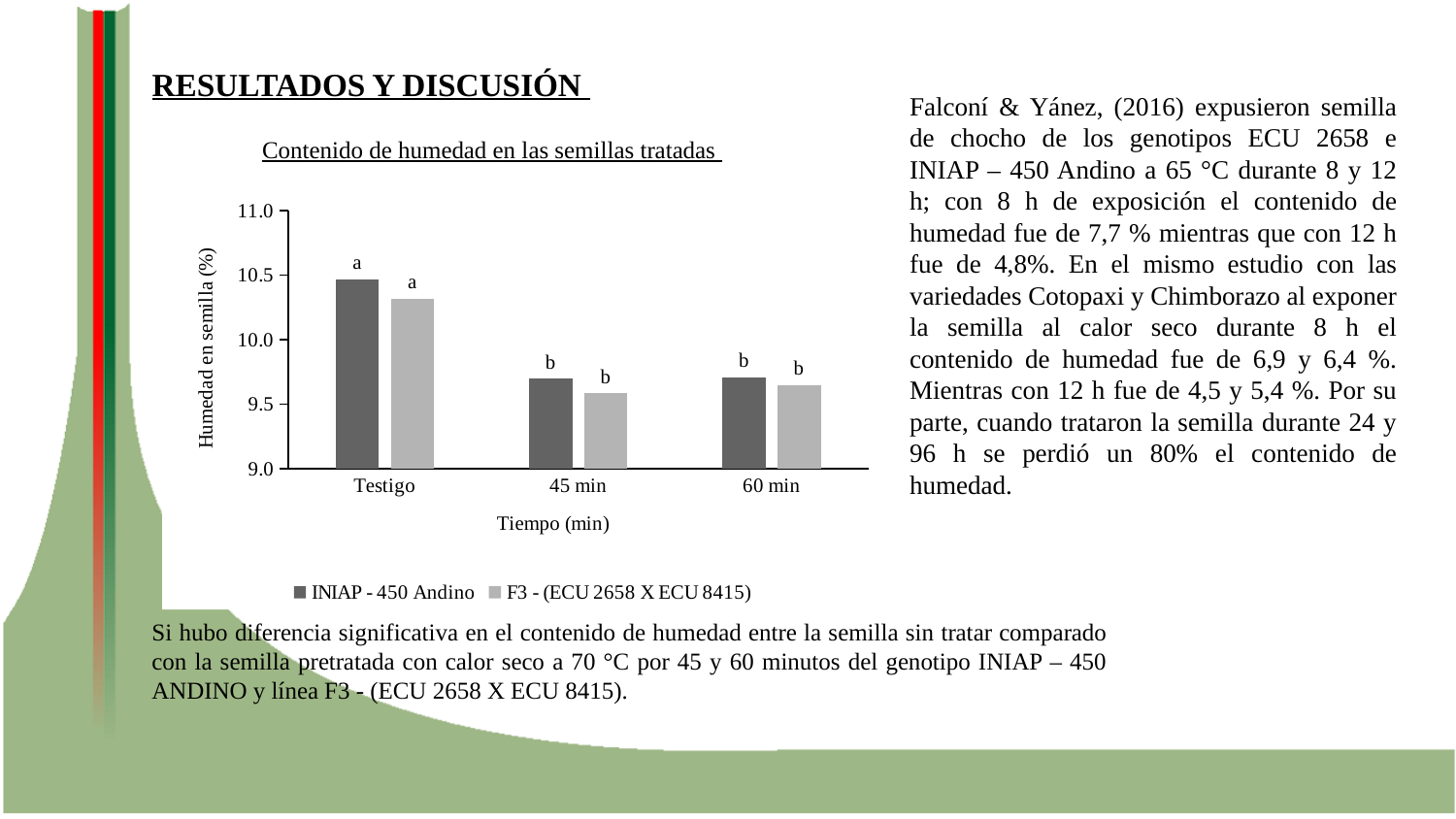
What is the title of the chart? Contenido de humedad en las semillas tratadas Is the value for INIAP - 450 Andino at 45 min greater or less than 10.0? less How many series does the chart legend list? 2 Is the value for F3 - (ECU 2658 X ECU 8415) at 60 min greater or less than 9.5? greater Is the value for INIAP - 450 Andino at Testigo greater or less than 10.0? greater What kind of chart is shown on the slide? bar chart What is the label of the y axis of the chart? Humedad en semilla (%) How many categories are shown on the x axis of the chart? 3 For the INIAP - 450 Andino series, which category has the highest value? Testigo For the F3 - (ECU 2658 X ECU 8415) series, which category has the highest value? Testigo Which is larger for INIAP - 450 Andino: the value at Testigo or the value at 45 min? Testigo Do the INIAP - 450 Andino values rise or fall from Testigo to 45 min? fall